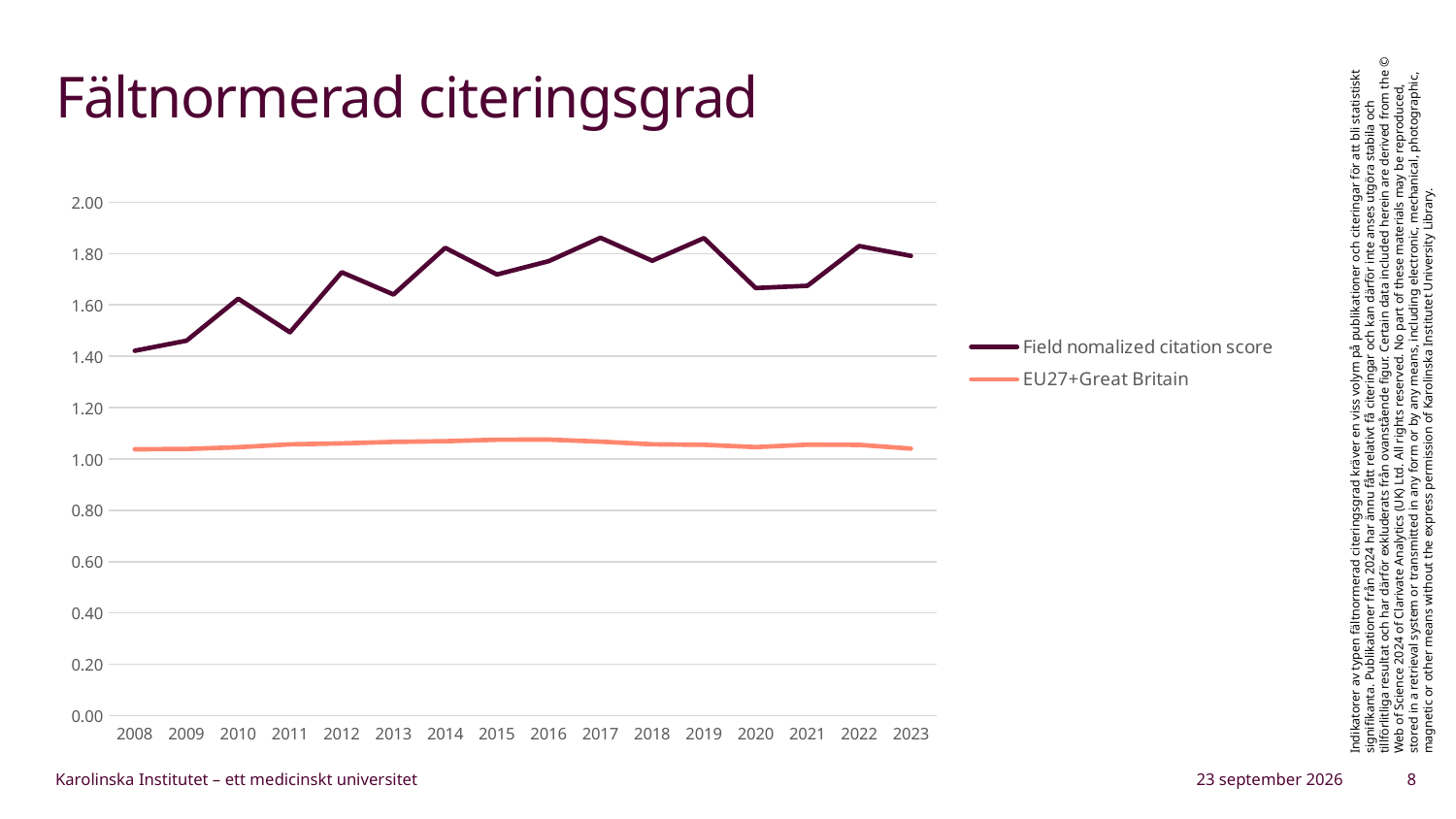
In 2015, which series has the higher value: Field nomalized citation score or EU27+Great Britain? Field nomalized citation score Is the Field nomalized citation score for 2008 greater or less than 1.60? less Which series is drawn in orange? EU27+Great Britain How many series does the legend list? 2 Is the EU27+Great Britain value for 2016 greater or less than 1.20? less Which is larger for the Field nomalized citation score: the value for 2011 or the value for 2012? 2012 What kind of chart is shown on the slide? line chart How many years are plotted along the x axis? 16 What is the title of the chart? Fältnormerad citeringsgrad Does the Field nomalized citation score overall rise or fall from 2008 to 2023? rise In which year is the Field nomalized citation score lowest? 2008 Is the Field nomalized citation score for 2017 greater or less than 1.80? greater